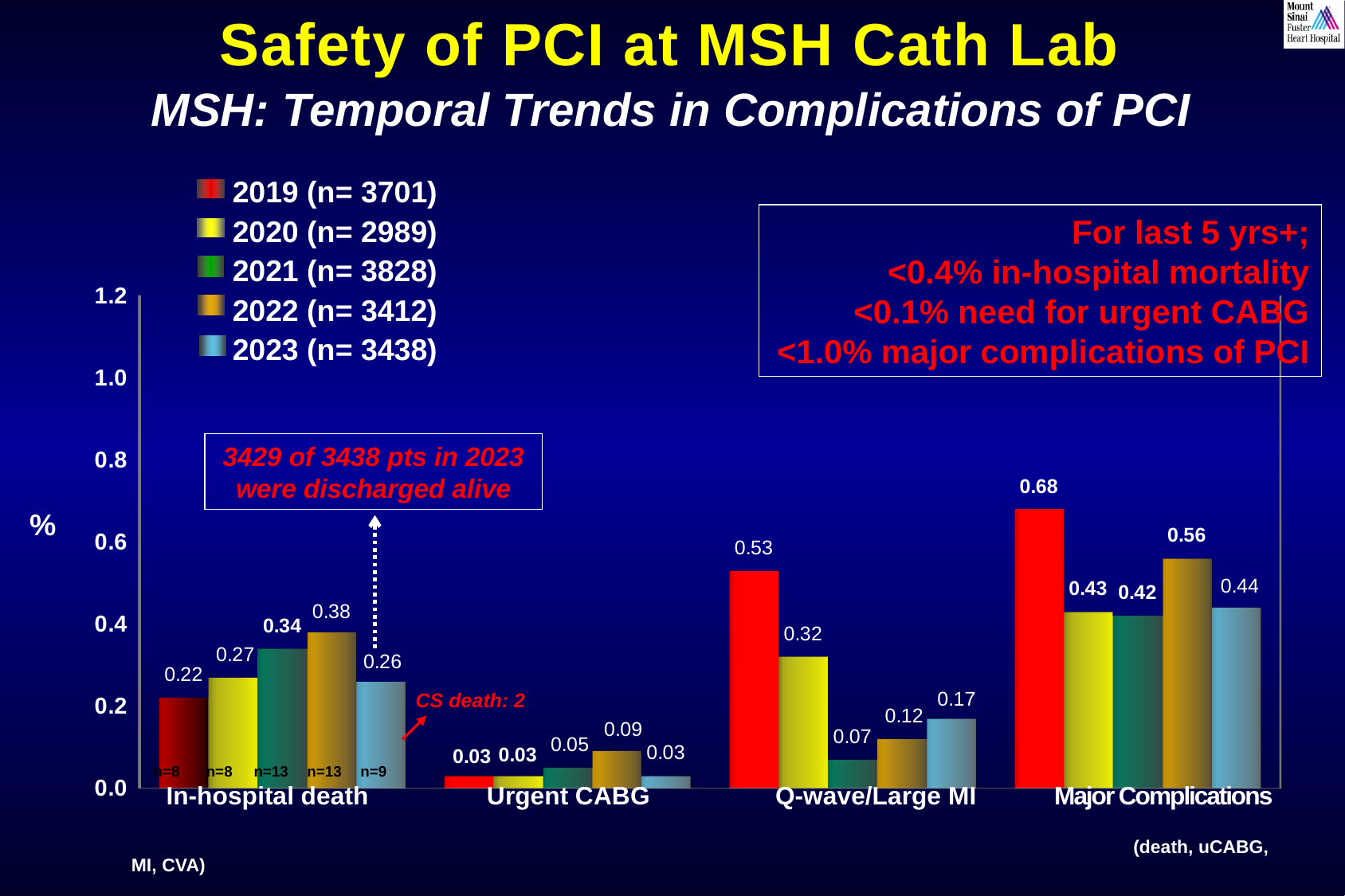
Which year has the lowest value in the In-hospital death category? 2019 Which is larger: the 2022 value for Urgent CABG or the 2021 value for Urgent CABG? 2022 What is the value for 2023 in the Q-wave/Large MI category? 0.17 Is the 2019 value for Major Complications greater or less than 0.6? greater Which year has the highest value in the Q-wave/Large MI category? 2019 What is the sample size (n) shown in the legend for 2021? 3828 How many categories are shown on the x axis? 4 What is the value for 2019 in the Major Complications category? 0.68 What is the value for 2022 in the In-hospital death category? 0.38 What is the difference between the 2019 and 2023 values in the Major Complications category? 0.24 What kind of chart is shown on the slide? bar chart How many series does the legend list? 5